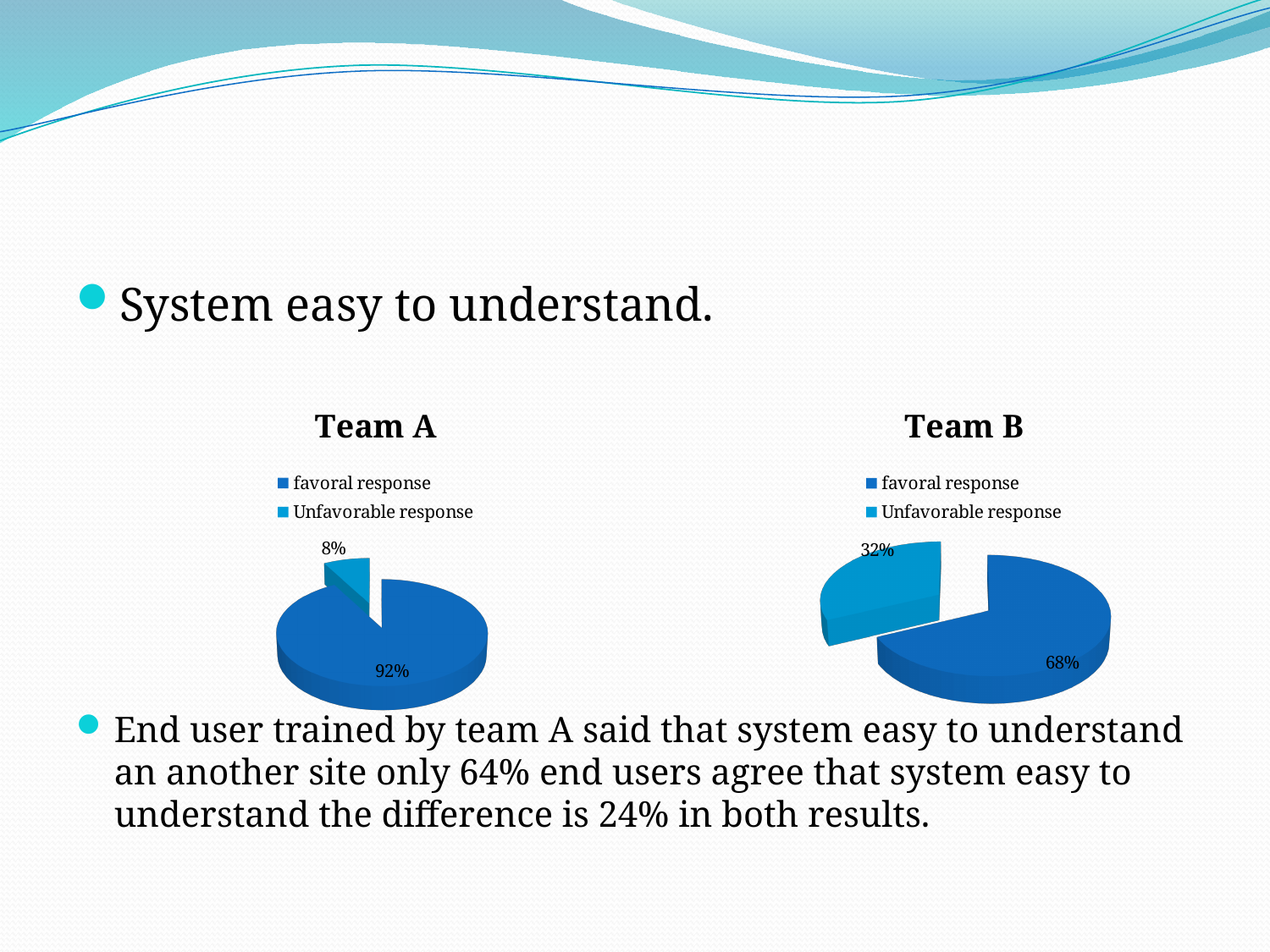
In the Team B chart, which slice is the largest? favoral response In the Team B chart, what is the difference between the favoral response and Unfavorable response slices? 36% In the Team B chart, what percentage is the Unfavorable response slice? 32% In the Team A chart, what percentage is the Unfavorable response slice? 8% Which chart has the larger favoral response share, Team A or Team B? Team A In the Team A chart, what is the difference between the favoral response and Unfavorable response slices? 84% How many entries does the legend of the Team A chart list? 2 What kind of chart is the Team A chart? Pie chart How many slices does the Team B chart have? 2 In the Team A chart, which slice is the smallest? Unfavorable response In the Team A chart, what percentage is the favoral response slice? 92% In the Team B chart, what percentage is the favoral response slice? 68%